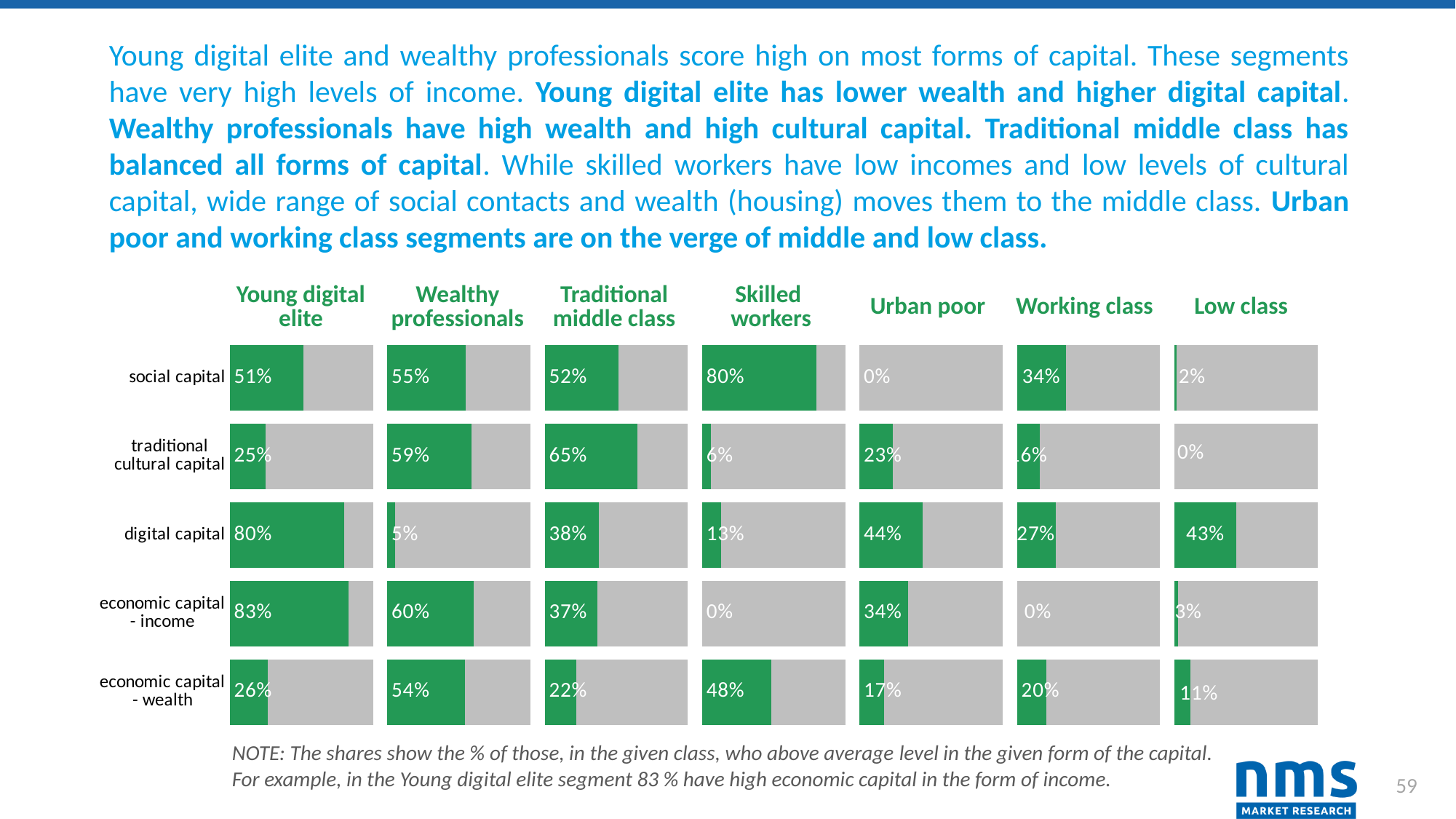
What is the difference between the economic capital - wealth values for Wealthy professionals and Young digital elite? 28% What percentage of the Young digital elite segment has above-average economic capital in the form of income? 83% How many forms of capital (rows) are shown in the chart? 5 Which segment has the highest social capital value? Skilled workers How many segments (columns) are shown in the chart? 7 What colour are the bars representing the share of each class with above-average capital? Green What is the digital capital value shown for Wealthy professionals? 5% What is the social capital value shown for Skilled workers? 80% Which segment has the lowest digital capital value? Wealthy professionals What kind of chart is used to show the shares on this slide? Bar chart What is the traditional cultural capital value shown for Traditional middle class? 65% Which is larger: the digital capital value for Urban poor or for Low class? Urban poor